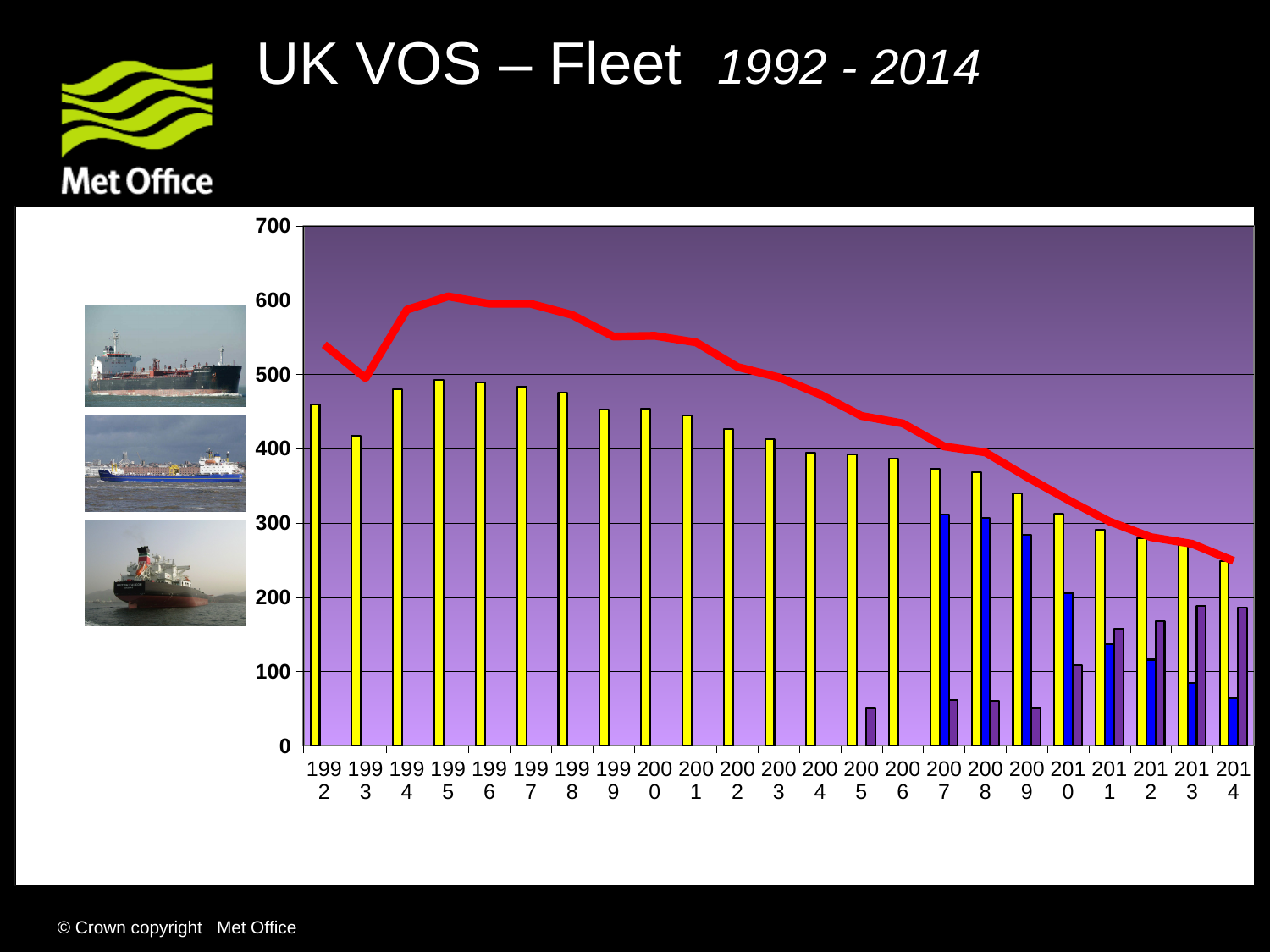
Is the value of the red line for 2000 greater or less than 500? greater Does the red line generally rise or fall from 1994 to 2014? Fall In which year is the yellow bar lowest? 2014 Which is larger, the yellow bar for 1992 or the yellow bar for 2014? 1992 Is the value of the yellow bar for 1992 greater or less than 400? greater Which is larger, the red line value for 1993 or for 1994? 1994 How many years are shown along the x axis of the chart? 23 Is the value of the yellow bar for 2014 greater or less than 300? less What is the first year shown on the x axis of the chart? 1992 In which year does the red line reach its lowest value? 2014 What kind of chart is shown on the slide? A bar chart with a line overlaid